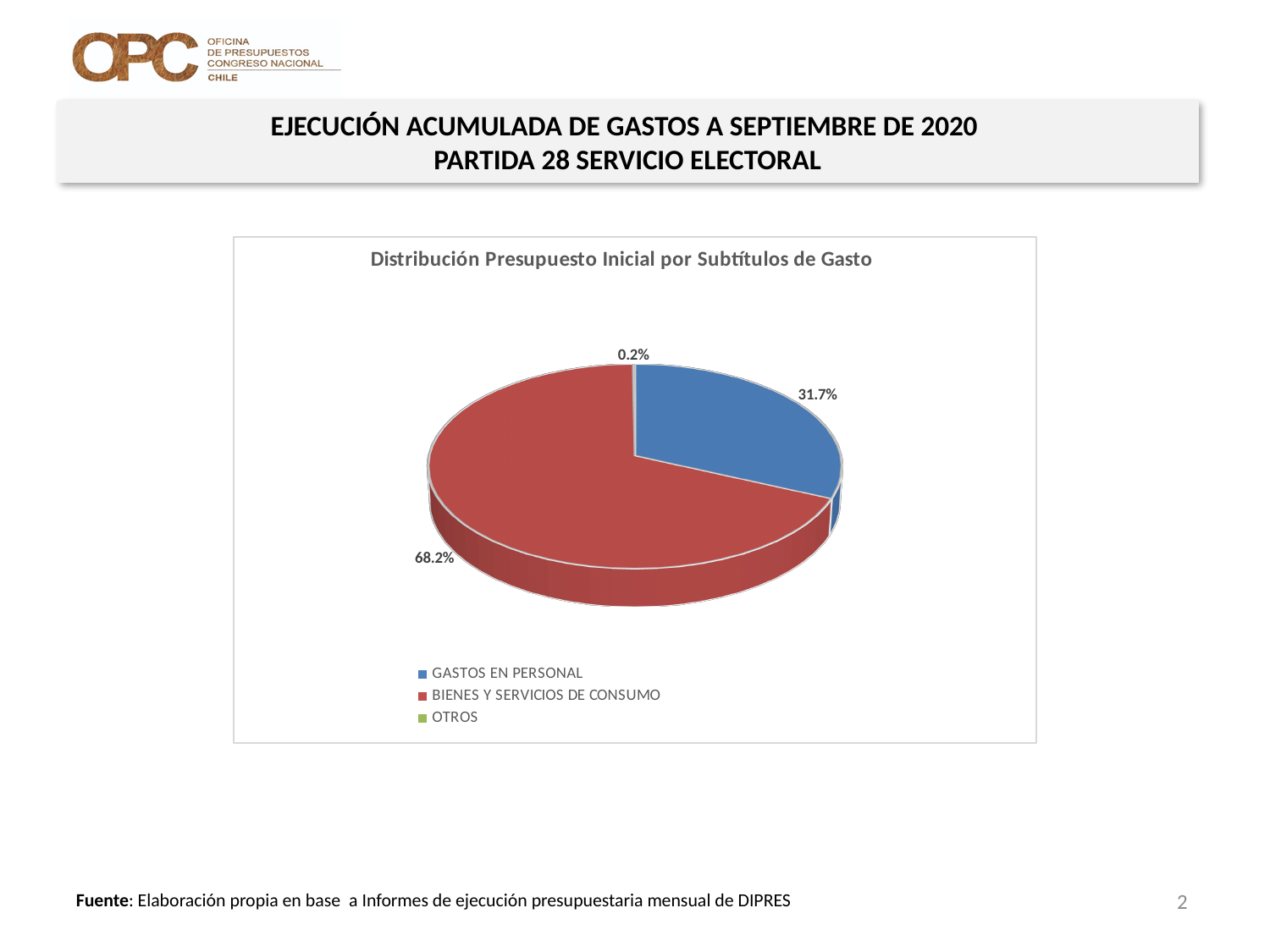
Is the share for GASTOS EN PERSONAL greater or less than 50%? less Which category has the largest slice of the pie? BIENES Y SERVICIOS DE CONSUMO Which colour represents GASTOS EN PERSONAL in the chart? Blue How many categories does the legend list? 3 What is the title of the chart? Distribución Presupuesto Inicial por Subtítulos de Gasto What share of the pie does GASTOS EN PERSONAL represent? 31.7% What is the difference in percentage points between BIENES Y SERVICIOS DE CONSUMO and GASTOS EN PERSONAL? 36.5 What share of the pie does OTROS represent? 0.2% Which category has the smallest slice of the pie? OTROS What kind of chart is shown on the slide? Pie chart What share of the pie does BIENES Y SERVICIOS DE CONSUMO represent? 68.2% Which is larger, the share for GASTOS EN PERSONAL or the share for OTROS? GASTOS EN PERSONAL